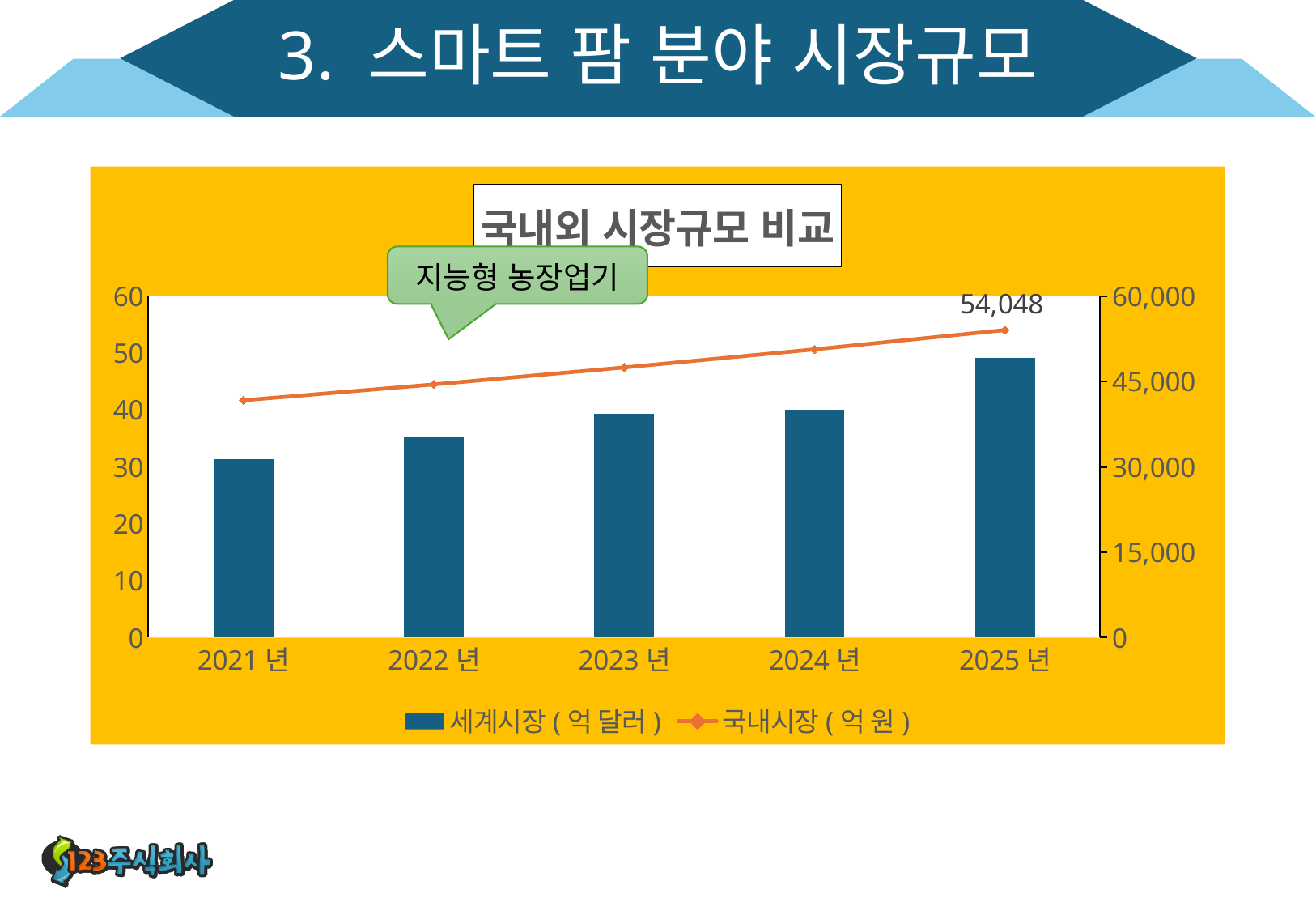
Is the 세계시장 ( 억 달러 ) value for 2021 년 greater or less than 40? less How many years are shown on the x axis of the chart? 5 What is the value of the 국내시장 ( 억 원 ) series for 2025 년? 54,048 Which year has the larger 세계시장 ( 억 달러 ) bar, 2021 년 or 2025 년? 2025 년 Which series is drawn as a line in the chart? 국내시장 ( 억 원 ) Is the 세계시장 ( 억 달러 ) value for 2025 년 greater or less than 40? greater Do the 세계시장 ( 억 달러 ) bars rise or fall from 2021 년 to 2025 년? Rise How many series does the legend list? 2 What kind of chart is shown on the slide? A combined bar and line chart What is the title of the chart? 국내외 시장규모 비교 Which year has the highest 세계시장 ( 억 달러 ) bar? 2025 년 Which year has the lowest 세계시장 ( 억 달러 ) bar? 2021 년